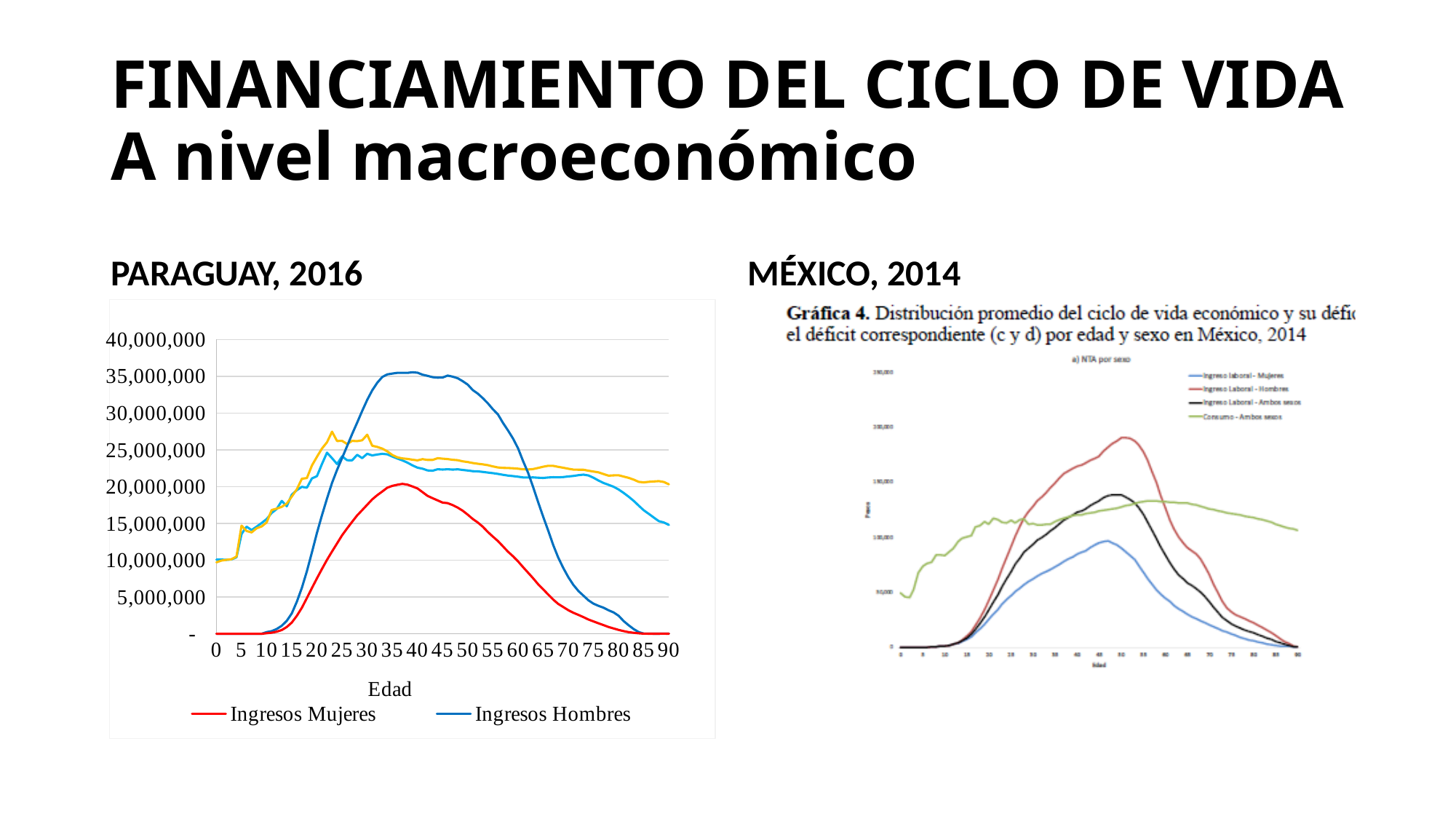
In the PARAGUAY, 2016 chart, is the value of Ingresos Hombres at age 60 greater or less than 20,000,000? greater In the PARAGUAY, 2016 chart, at age 40, which is larger, Ingresos Mujeres or Ingresos Hombres? Ingresos Hombres What is the label of the x axis of the PARAGUAY, 2016 chart? Edad What colour is the Ingresos Mujeres line in the PARAGUAY, 2016 chart? red In the PARAGUAY, 2016 chart, is the peak value of Ingresos Hombres greater or less than 30,000,000? greater In the PARAGUAY, 2016 chart, does Ingresos Hombres rise or fall between age 50 and age 85? fall In the PARAGUAY, 2016 chart, is the peak value of Ingresos Mujeres greater or less than 25,000,000? less In the PARAGUAY, 2016 chart, does Ingresos Mujeres rise or fall between age 15 and age 35? rise In the PARAGUAY, 2016 chart, which series reaches the higher peak, Ingresos Mujeres or Ingresos Hombres? Ingresos Hombres What kind of chart is the PARAGUAY, 2016 chart? line chart How many series does the legend of the PARAGUAY, 2016 chart list? 2